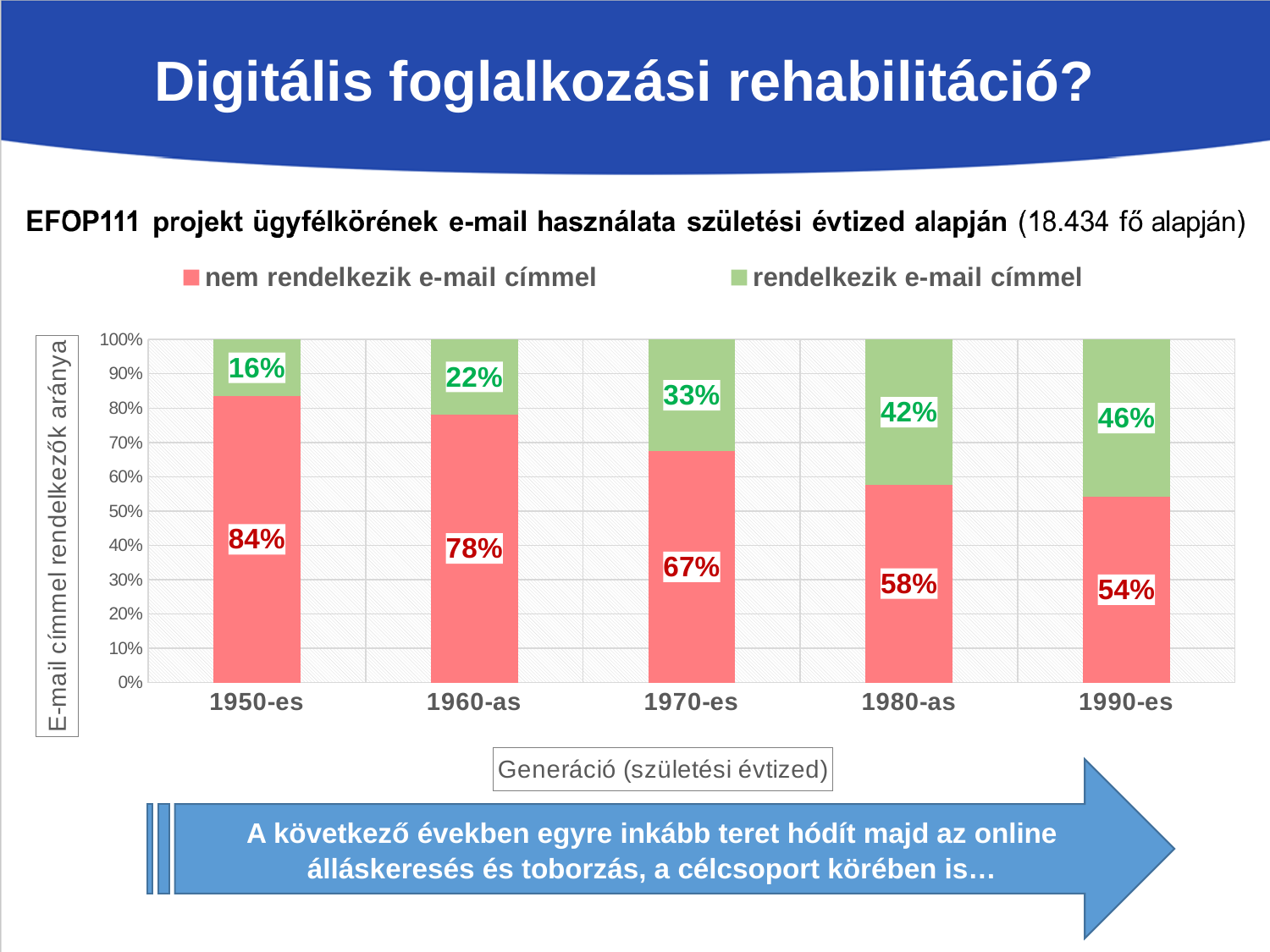
What is the label of the x axis? Generáció (születési évtized) What percentage of the 1950-es generation does not have an e-mail address (nem rendelkezik e-mail címmel)? 84% How many series does the legend list? 2 What percentage of the 1990-es generation has an e-mail address (rendelkezik e-mail címmel)? 46% Which is larger: the 'rendelkezik e-mail címmel' value for 1980-as or for 1960-as? 1980-as Which generation has the lowest share of people without an e-mail address (nem rendelkezik e-mail címmel)? 1990-es Which generation has the highest share of people with an e-mail address (rendelkezik e-mail címmel)? 1990-es Does the share of people with an e-mail address (rendelkezik e-mail címmel) rise or fall from the 1950-es to the 1990-es generation? Rise What kind of chart is shown on the slide? Stacked bar chart What is the difference between the 'nem rendelkezik e-mail címmel' values for the 1950-es and 1990-es generations? 30% How many generations (categories) are shown on the x axis? 5 What is the value for 'rendelkezik e-mail címmel' for the 1970-es generation? 33%